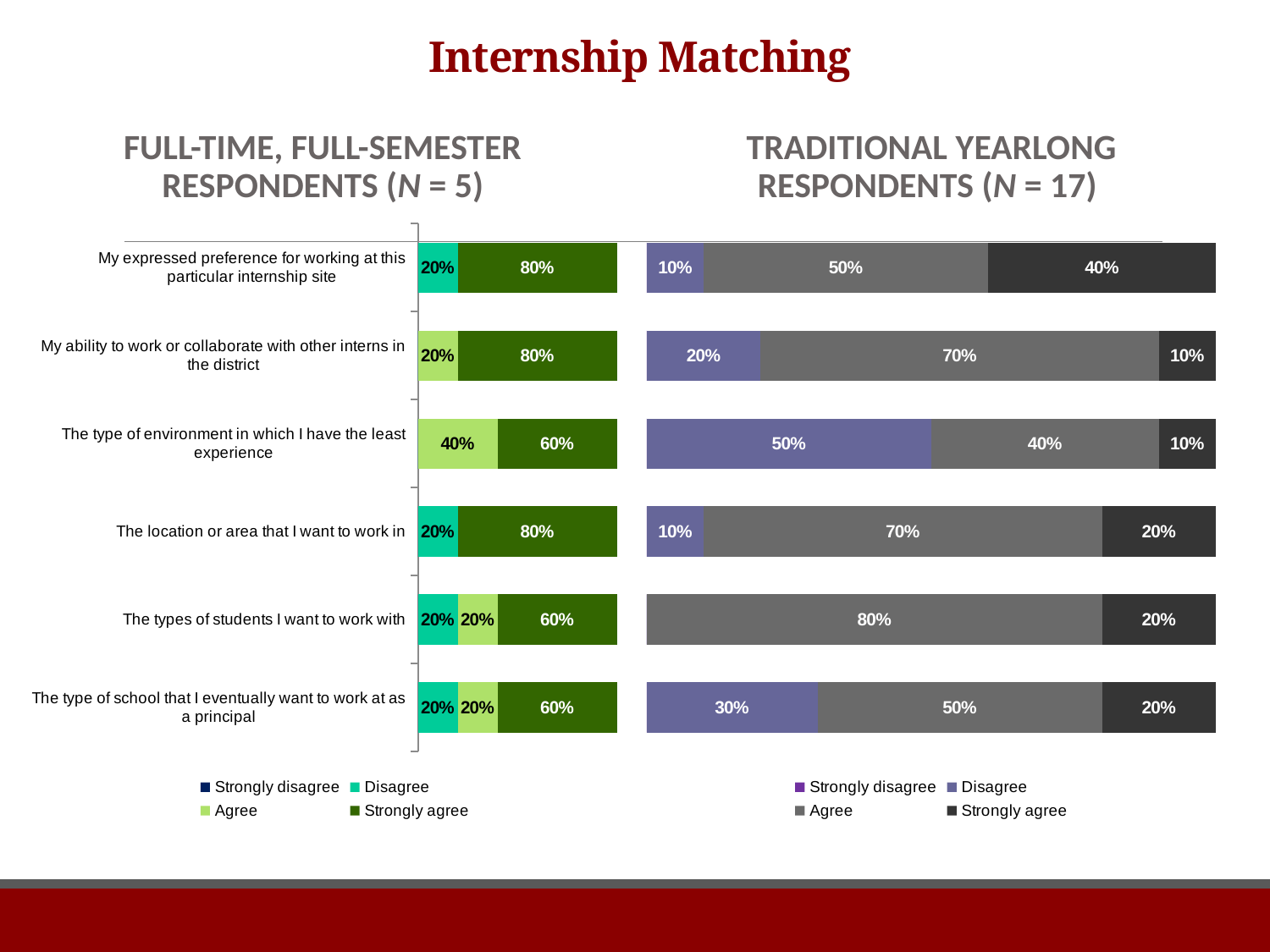
In the Traditional yearlong respondents chart, what percentage disagree for 'The type of environment in which I have the least experience'? 50% What kind of chart is the Traditional yearlong respondents chart? Stacked bar chart In the Traditional yearlong respondents chart, which category has the highest Disagree percentage? The type of environment in which I have the least experience In the Traditional yearlong respondents chart, which is larger: the Strongly agree percentage for 'My expressed preference for working at this particular internship site' or for 'My ability to work or collaborate with other interns in the district'? My expressed preference for working at this particular internship site In the Full-time, full-semester respondents chart, what is the difference between the Strongly agree percentages for 'The location or area that I want to work in' and 'The types of students I want to work with'? 20% In the Full-time, full-semester respondents chart, what percentage strongly agree for 'The type of environment in which I have the least experience'? 60% In the Traditional yearlong respondents chart, what percentage agree for 'The types of students I want to work with'? 80% How many series does the legend of the Traditional yearlong respondents chart list? 4 In the Traditional yearlong respondents chart, what is the combined Agree and Strongly agree percentage for 'The type of school that I eventually want to work at as a principal'? 70% In the Traditional yearlong respondents chart, what percentage strongly agree for 'My expressed preference for working at this particular internship site'? 40% In the Traditional yearlong respondents chart, which category has the highest Agree percentage? The types of students I want to work with How many categories are shown in the Full-time, full-semester respondents chart? 6